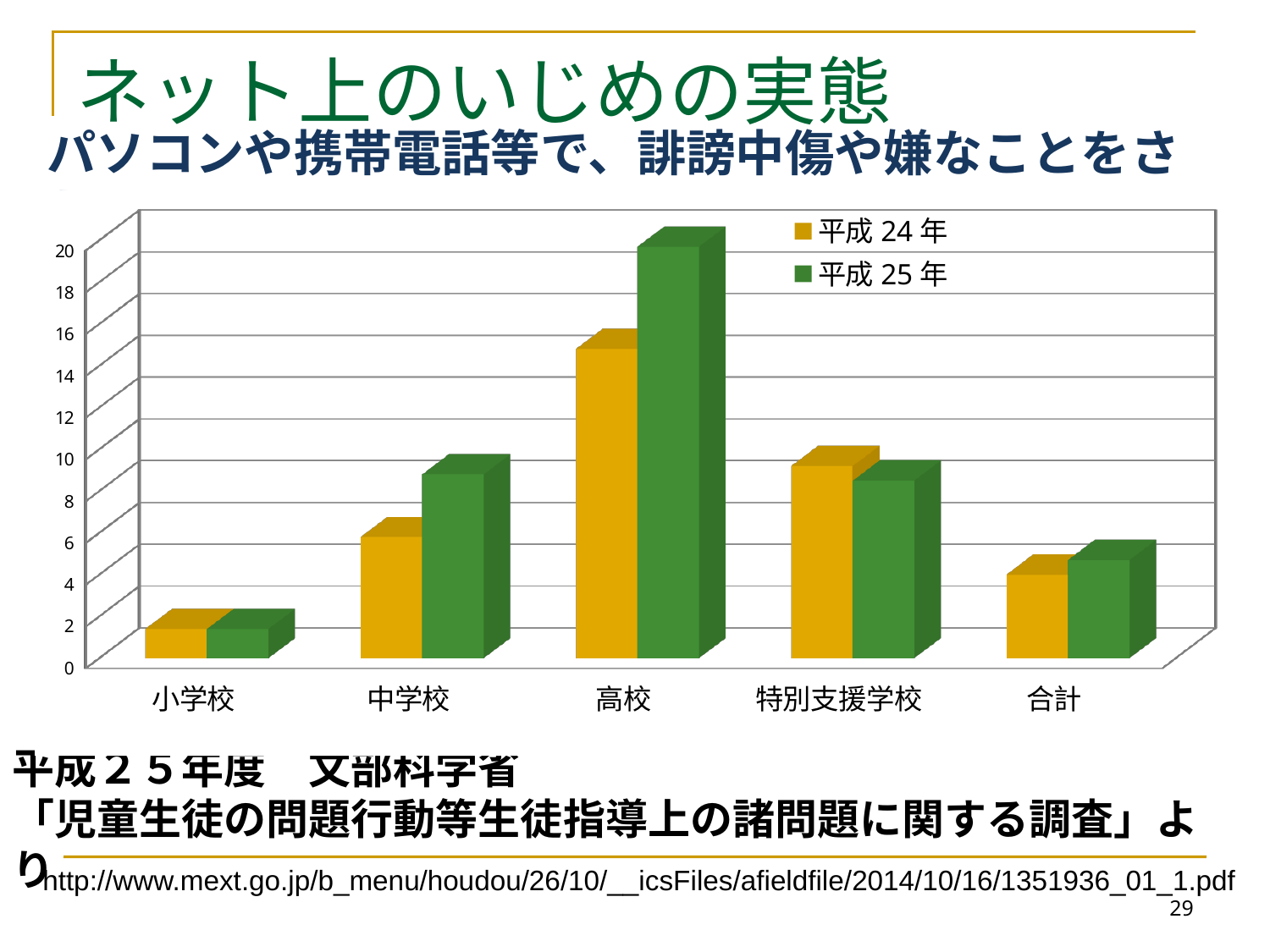
For 特別支援学校, which series has the larger value, 平成24年 or 平成25年? 平成24年 Which series is shown in green in the legend? 平成25年 Is the value for 中学校 in 平成24年 greater or less than 8? less What kind of chart is shown on the slide? bar chart Which category has the lowest value for 平成25年? 小学校 Is the value for 合計 in 平成25年 greater or less than 8? less Which category has the highest value for 平成25年? 高校 How many categories are shown on the x axis? 5 Which category has the highest value for 平成24年? 高校 How many series does the legend list? 2 Is the value for 高校 in 平成25年 greater or less than 18? greater For 高校, which series has the larger value, 平成24年 or 平成25年? 平成25年